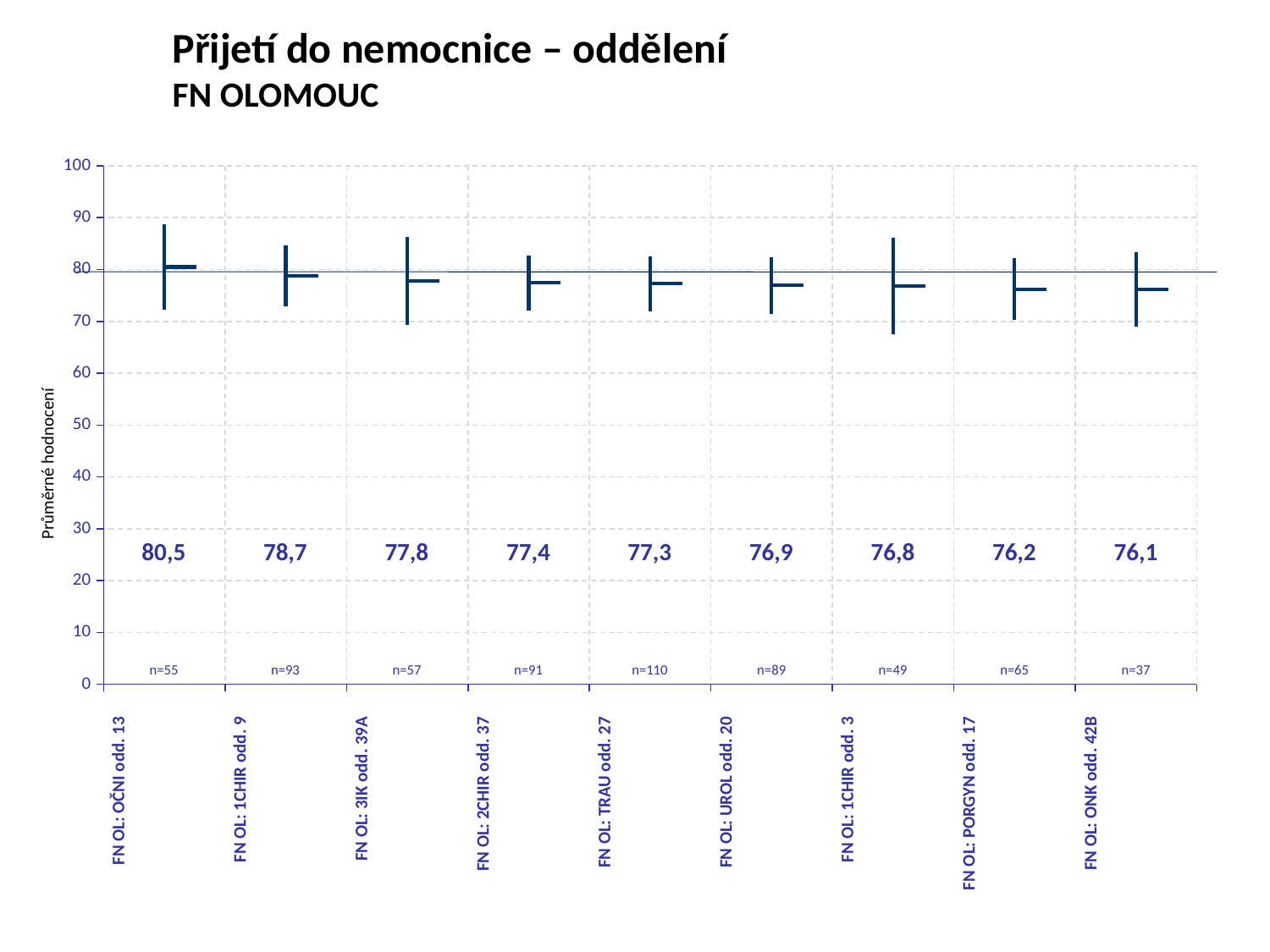
What is the title of the chart? Přijetí do nemocnice – oddělení FN OLOMOUC Do the average ratings rise or fall from left to right along the x axis? fall What is the average rating for FN OL: ONK odd. 42B? 76,1 Which department has the smallest number of respondents (n)? FN OL: ONK odd. 42B Which department has the lowest average rating? FN OL: ONK odd. 42B Which department has the highest average rating? FN OL: OČNI odd. 13 What is the average rating (Průměrné hodnocení) for FN OL: OČNI odd. 13? 80,5 Which has a higher average rating, FN OL: 1CHIR odd. 9 or FN OL: UROL odd. 20? FN OL: 1CHIR odd. 9 What is the average rating for FN OL: TRAU odd. 27? 77,3 How many departments are shown on the chart? 9 What is the difference between the average ratings of FN OL: OČNI odd. 13 and FN OL: ONK odd. 42B? 4,4 What is the number of respondents (n) shown for FN OL: TRAU odd. 27? n=110